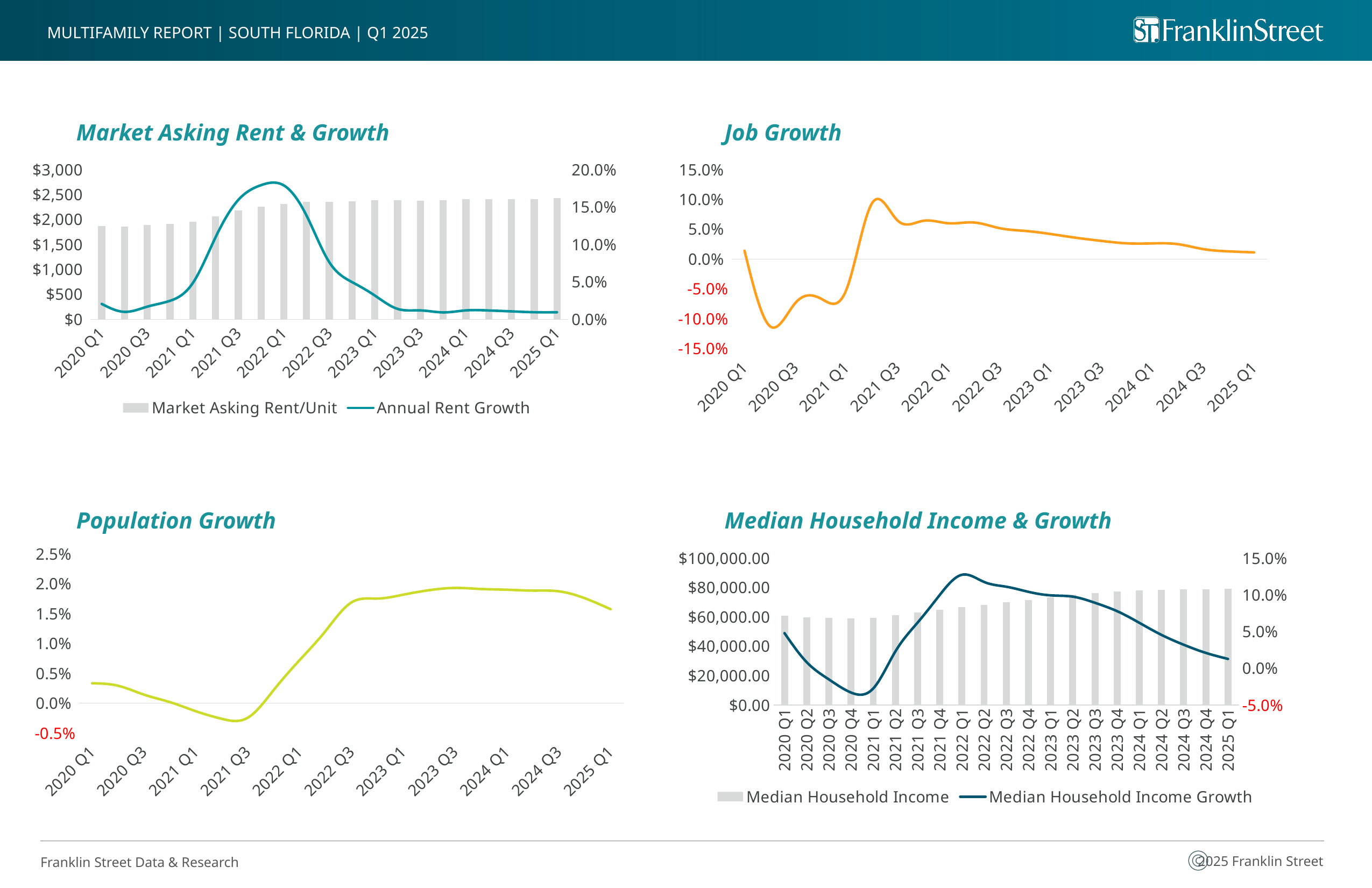
In the Job Growth chart, is the value for 2020 Q3 greater or less than -5.0%? less In the Market Asking Rent & Growth chart, is the Market Asking Rent/Unit for 2020 Q1 greater or less than $2,000? less In the Median Household Income & Growth chart, is the Median Household Income for 2025 Q1 greater or less than $60,000.00? greater In the Market Asking Rent & Growth chart, what kind of chart is used for the Market Asking Rent/Unit series? bar chart In the Population Growth chart, does the value rise or fall from 2021 Q3 to 2023 Q3? rise In the Market Asking Rent & Growth chart, how many series does the legend list? 2 In the Job Growth chart, does the value rise or fall from 2021 Q3 to 2025 Q1? fall In the Median Household Income & Growth chart, what are the two legend entries? Median Household Income; Median Household Income Growth In the Median Household Income & Growth chart, how many quarters are shown on the x axis? 21 What kind of chart is the Job Growth chart? line chart